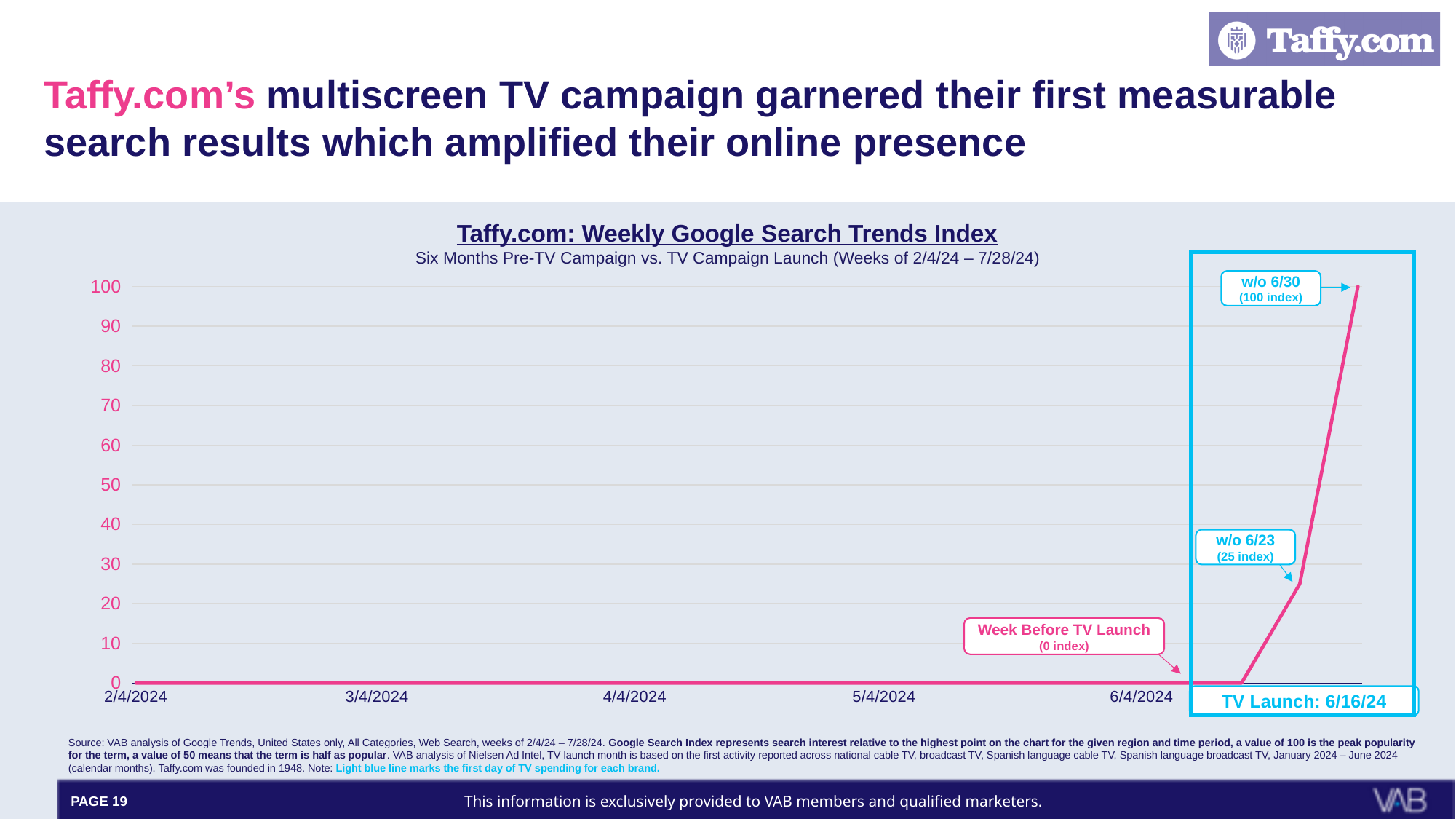
What is the search trends index value for the week before the TV launch? 0 Which week has the highest search trends index value on the chart? w/o 6/30 Is the index value at 3/4/2024 greater or less than 10? less How many date labels are shown on the x axis? 5 What is the search trends index value for the week of 6/30? 100 Does the index value rise or fall from the week of 6/23 to the week of 6/30? Rise What is the difference between the index value for the week of 6/30 and the week of 6/23? 75 What is the title of the chart? Taffy.com: Weekly Google Search Trends Index Which week has the higher index value, the week of 6/23 or the week of 6/30? w/o 6/30 What kind of chart is shown on the slide? Line chart What is the search trends index value for the week of 6/23? 25 What is the TV launch date marked on the chart? 6/16/24